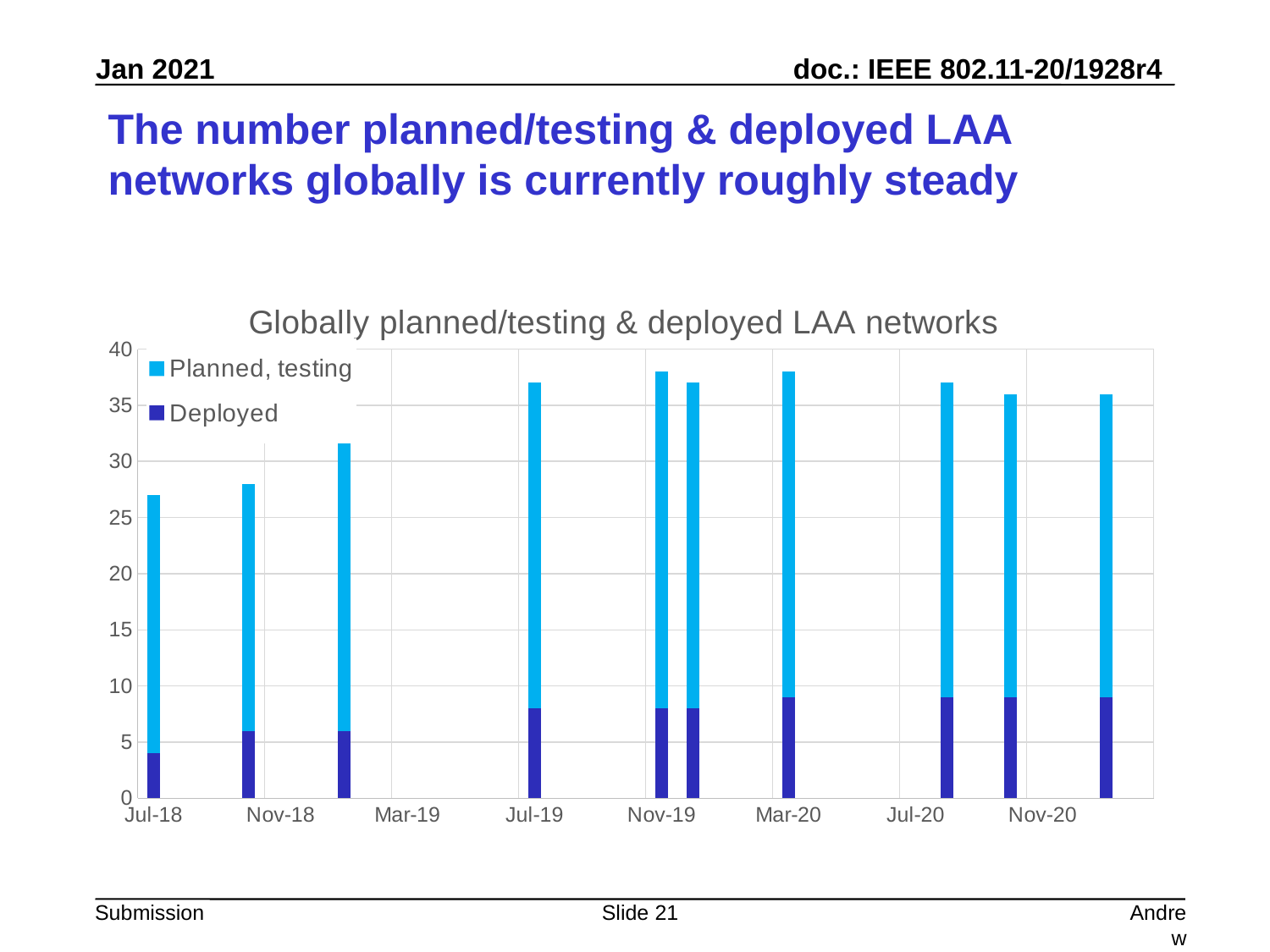
What kind of chart is shown on the slide? Stacked bar chart What is the title of the chart? Globally planned/testing & deployed LAA networks How many bars are plotted in the chart? 10 Is the Deployed value at Jul-18 greater or less than 5? less Is the Deployed value at Mar-20 greater or less than 10? less Is the total height of the bar at Jul-19 greater or less than 35? greater How many series does the legend list? 2 Which series is shown in dark blue in the legend? Deployed Is the total bar at Mar-20 taller or shorter than the total bar at Jul-18? taller Do the total bar heights generally rise or fall from Jul-18 to the end of the chart? rise